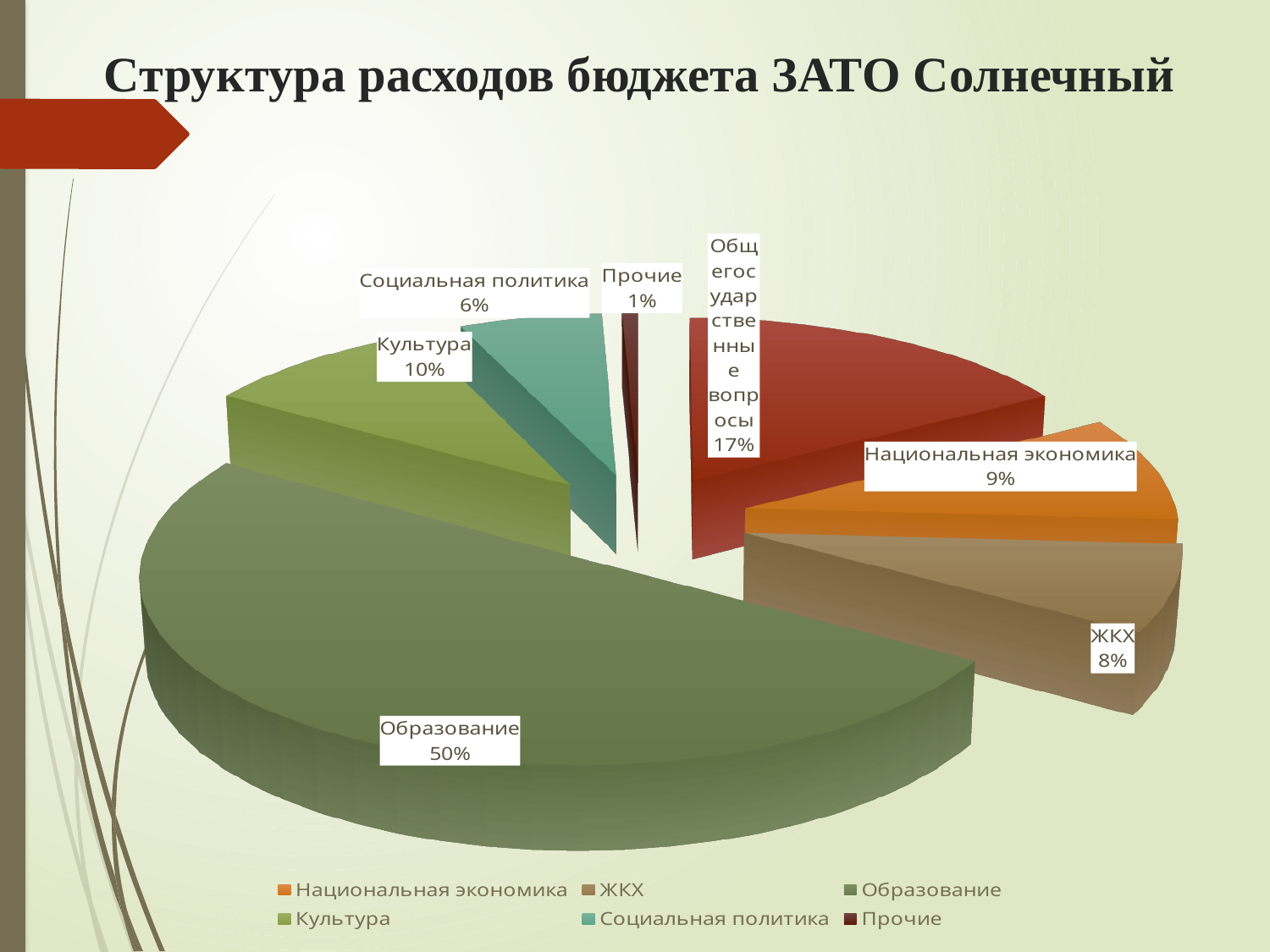
What share of the budget expenditure goes to ЖКХ? 8% What is the difference in percentage points between Культура and Социальная политика? 4 What is the title of the chart? Структура расходов бюджета ЗАТО Солнечный Which has a larger share, Национальная экономика or ЖКХ? Национальная экономика What kind of chart is shown on the slide? pie chart Which category has the largest share of the budget expenditure? Образование How many entries does the legend list? 6 What share of the budget expenditure goes to Социальная политика? 6% How many slices does the pie chart have? 7 What share of the budget expenditure goes to Образование? 50% Which category has the smallest share of the budget expenditure? Прочие What share of the budget expenditure goes to Общегосударственные вопросы? 17%